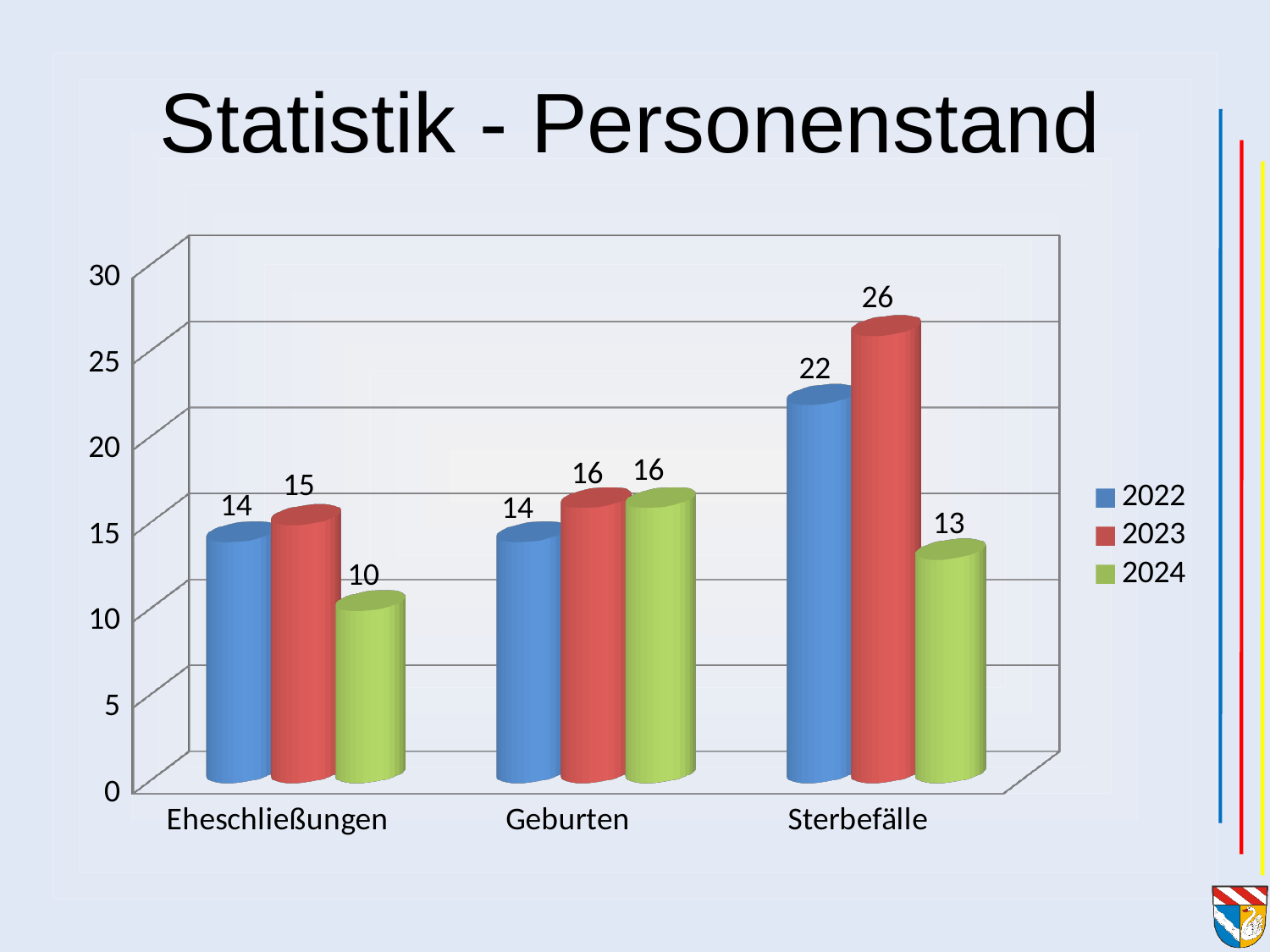
What is the difference between the 2023 and 2024 values for Sterbefälle? 13 What kind of chart is shown on the slide? Bar chart Which is larger, the 2022 value for Eheschließungen or the 2022 value for Sterbefälle? Sterbefälle How do the values for Eheschließungen change from 2023 to 2024? They fall What is the value for Sterbefälle in 2023? 26 Which category has the highest value for 2022? Sterbefälle How many categories are shown on the x axis? 3 Which category has the lowest value for 2024? Eheschließungen What is the value for Geburten in 2022? 14 How many series does the legend list? 3 What is the value for Eheschließungen in 2024? 10 What is the title of the slide? Statistik - Personenstand